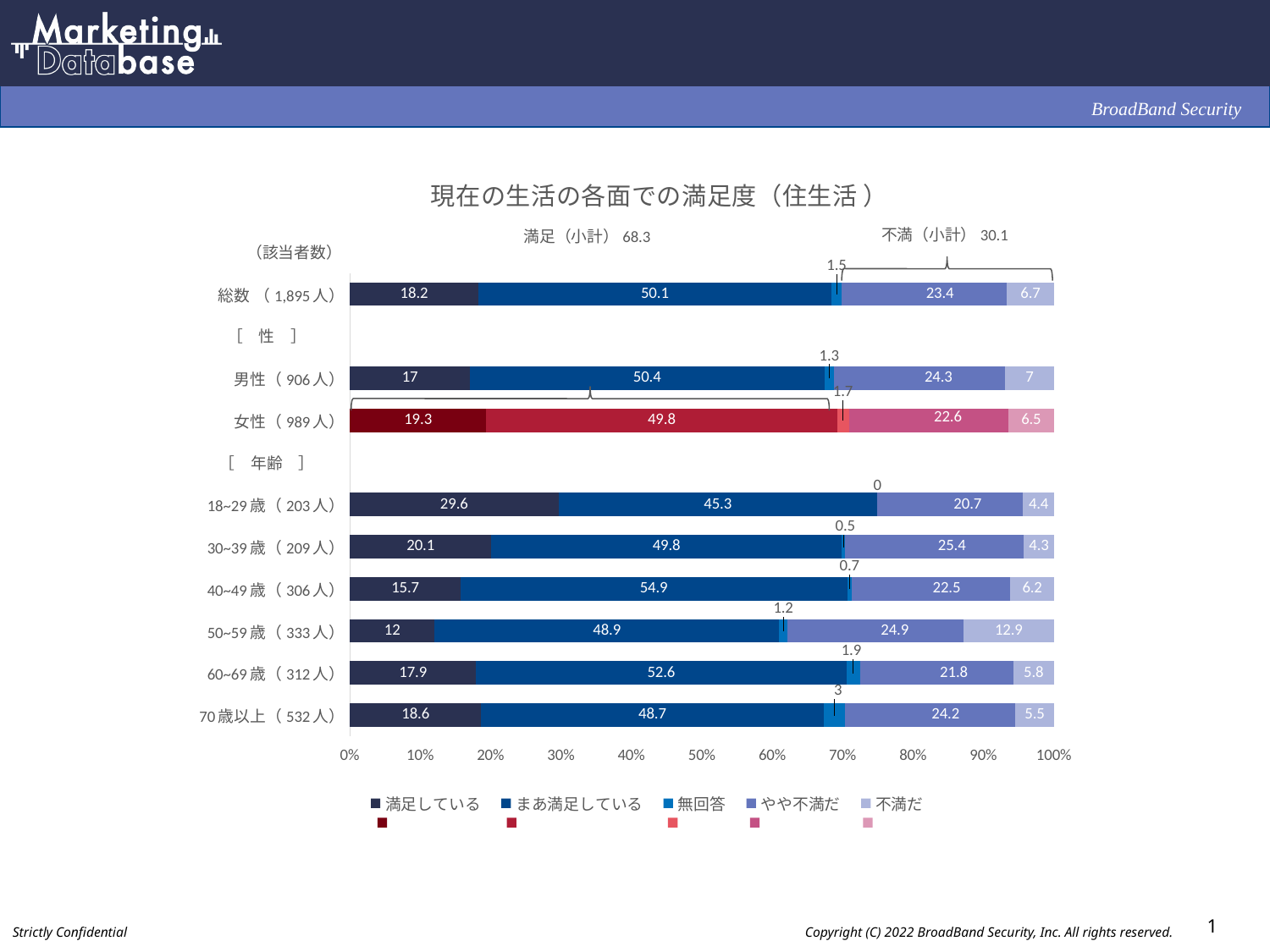
How many categories (rows) are plotted in the chart? 9 What is the 満足（小計） value shown above the chart? 68.3 Which category has the highest value for 満足している? 18~29歳 What is the difference between the やや不満だ values for 男性 and 女性? 1.7 What type of chart is shown on the slide? stacked bar chart What is the value of 満足している for 18~29歳? 29.6 Which category has the lowest value for 満足している? 50~59歳 What is the value of 無回答 for 70歳以上? 3 Which is larger, the まあ満足している value for 男性 or for 女性? 男性 What is the value of 不満だ for 50~59歳? 12.9 What is the value of まあ満足している for 40~49歳? 54.9 How many series does the legend list? 5